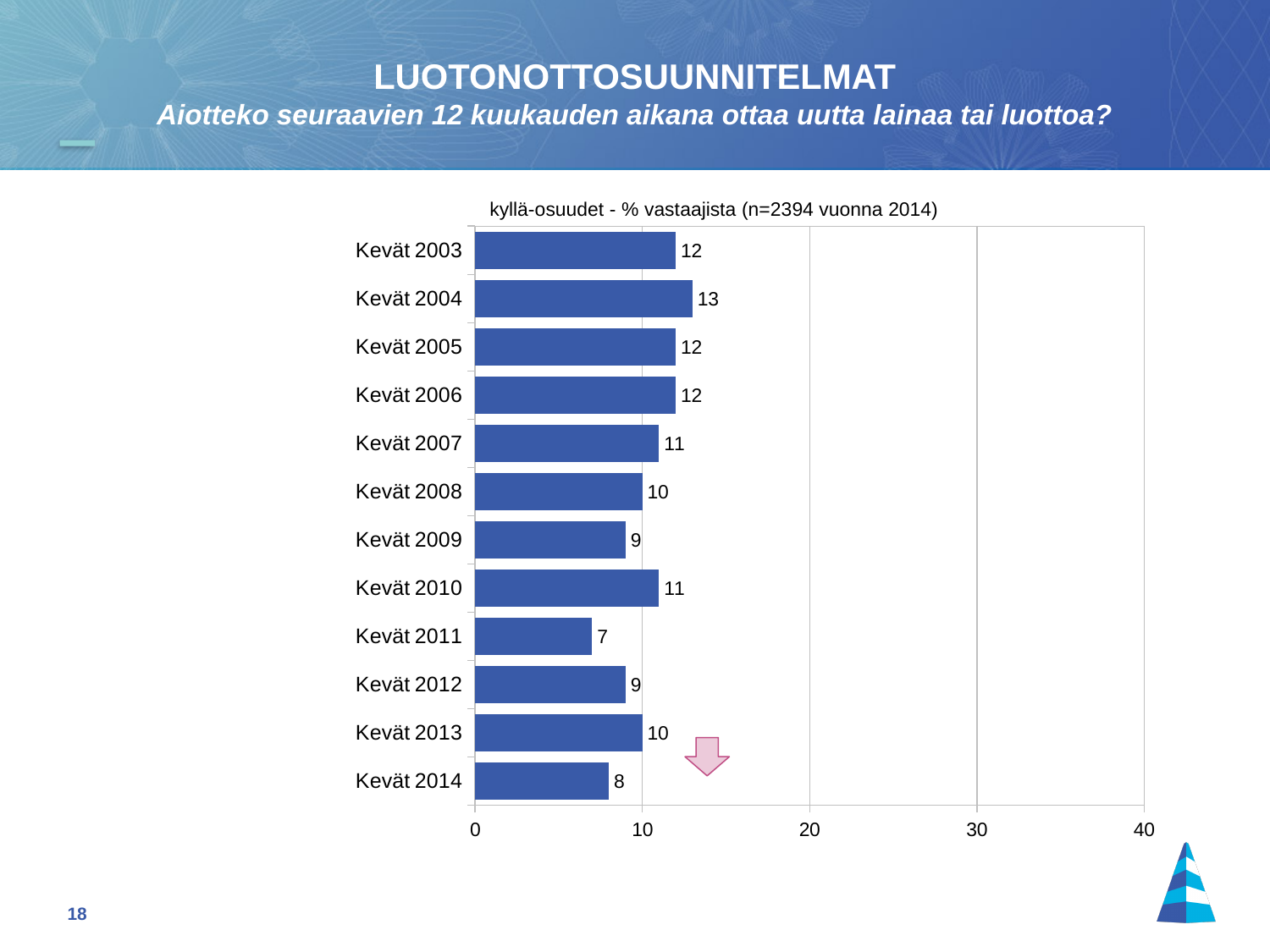
Is the value for Kevät 2003 greater or less than 20? less How many categories are shown on the chart? 12 What is the difference between the values for Kevät 2013 and Kevät 2014? 2 What kind of chart is shown on the slide? bar chart Which is larger, the value for Kevät 2007 or the value for Kevät 2009? Kevät 2007 What is the title of the chart? kyllä-osuudet - % vastaajista (n=2394 vuonna 2014) What is the value for Kevät 2014? 8 What is the value for Kevät 2004? 13 What is the value for Kevät 2011? 7 Which category has the lowest value? Kevät 2011 What is the maximum value shown on the horizontal axis? 40 Which category has the highest value? Kevät 2004